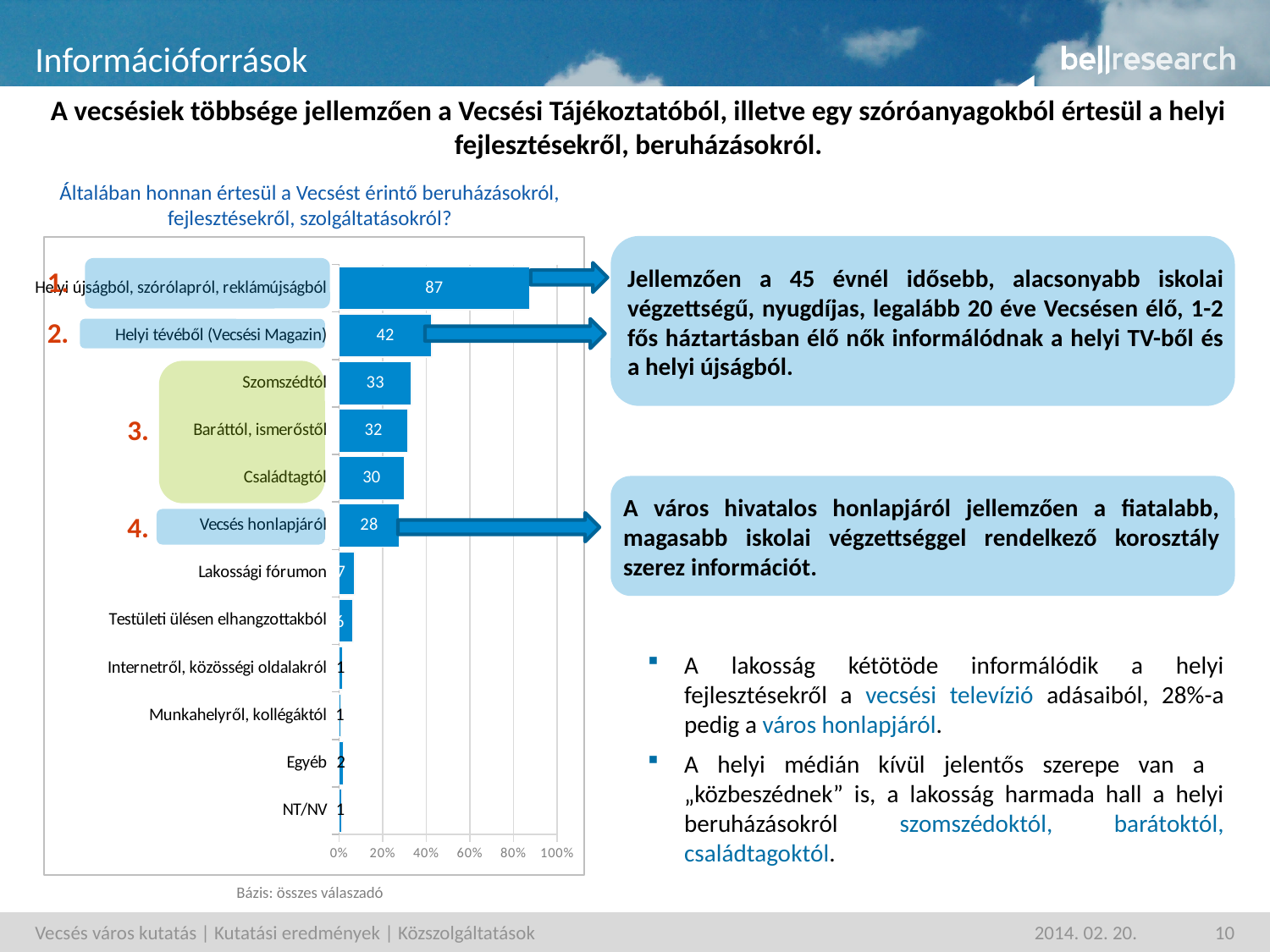
What is the difference between the values for "Helyi újságból, szórólapról, reklámújságból" and "Helyi tévéből (Vecsési Magazin)"? 45 Is the value for "Helyi újságból, szórólapról, reklámújságból" greater or less than 80%? greater Which is larger, the value for "Baráttól, ismerőstől" or the value for "Családtagtól"? Baráttól, ismerőstől How many categories are plotted in the chart? 12 Is the value for "Helyi tévéből (Vecsési Magazin)" greater or less than 60%? less What value is shown for "Helyi újságból, szórólapról, reklámújságból"? 87 What is the question shown as the chart's title? Általában honnan értesül a Vecsést érintő beruházásokról, fejlesztésekről, szolgáltatásokról? Which category has the highest value in the chart? Helyi újságból, szórólapról, reklámújságból What value is shown for "Vecsés honlapjáról"? 28 What kind of chart is shown on the slide? Bar chart What value is shown for "Helyi tévéből (Vecsési Magazin)"? 42 What value is shown for "Szomszédtól"? 33